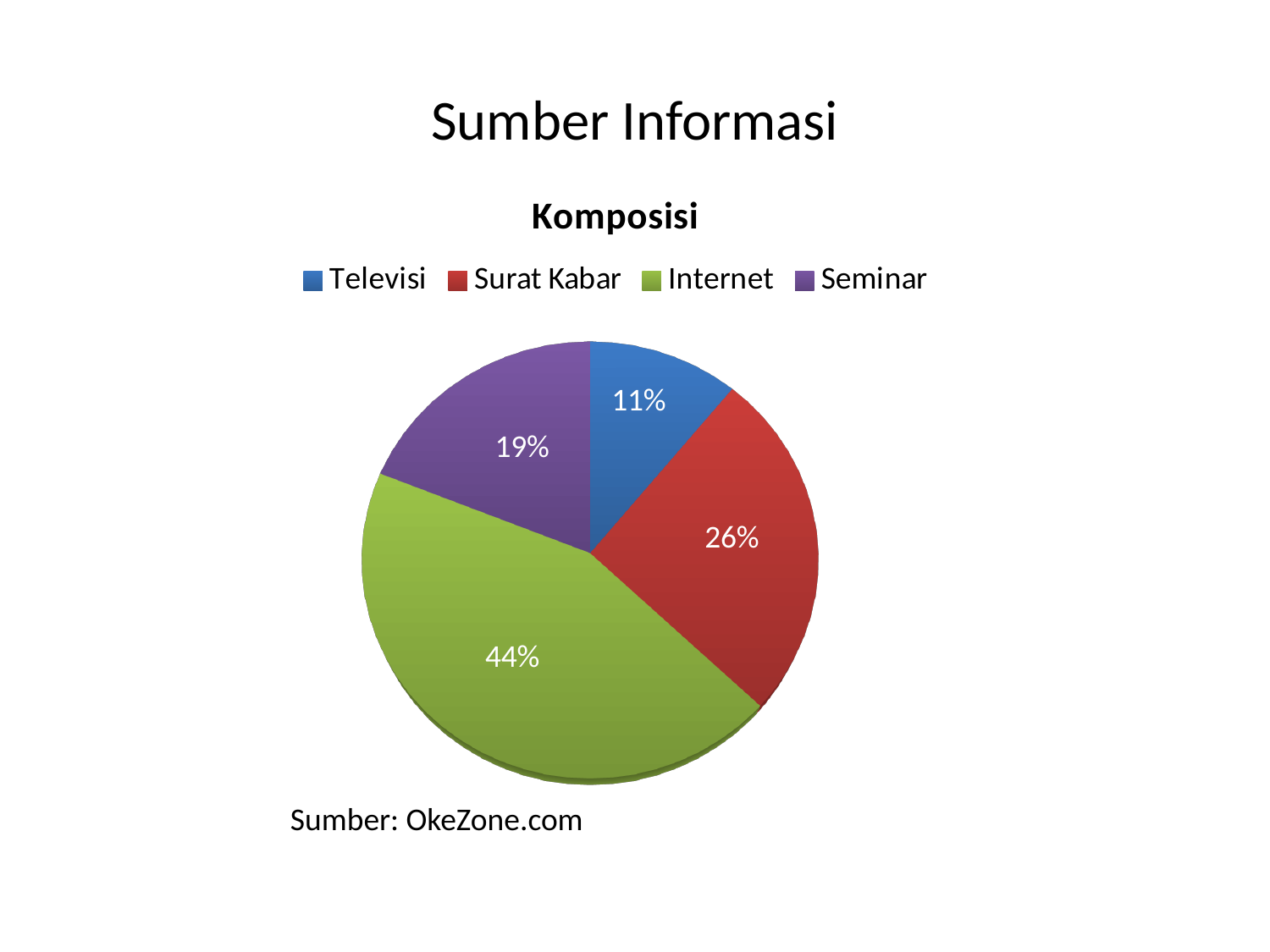
What is the difference in percentage points between Seminar and Televisi? 8 Which category has the smallest slice of the pie? Televisi What is the difference in percentage points between Internet and Surat Kabar? 18 What share of the pie does Seminar have? 19% What share of the pie does Internet have? 44% Which is larger, Surat Kabar or Seminar? Surat Kabar How many categories are shown in the pie chart? 4 What share of the pie does Surat Kabar have? 26% What kind of chart is shown on the slide? Pie chart What is the title of the chart? Komposisi Which category has the largest slice of the pie? Internet